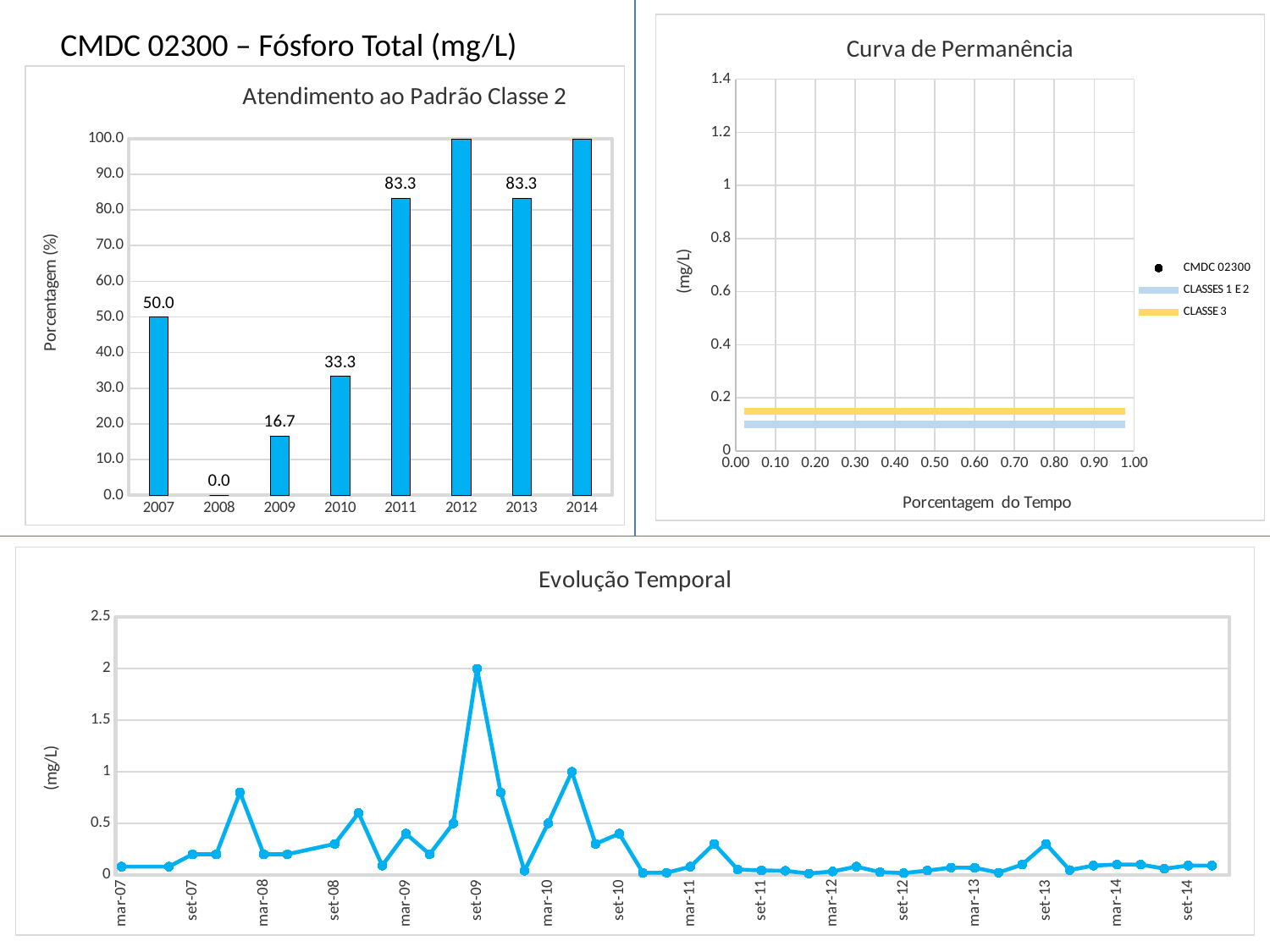
In the 'Atendimento ao Padrão Classe 2' chart, which year has the lowest value? 2008 In the 'Atendimento ao Padrão Classe 2' chart, which year has the larger value, 2009 or 2010? 2010 How many years are shown in the 'Atendimento ao Padrão Classe 2' chart? 8 In the 'Atendimento ao Padrão Classe 2' chart, what is the value for 2007? 50.0 How many series does the legend of the 'Curva de Permanência' chart list? 3 In the 'Evolução Temporal' chart, is the highest value greater or less than 1.5? greater In the 'Atendimento ao Padrão Classe 2' chart, what is the difference between the values for 2011 and 2010? 50.0 In the 'Atendimento ao Padrão Classe 2' chart, what is the value for 2011? 83.3 What are the legend entries in the 'Curva de Permanência' chart? CMDC 02300, CLASSES 1 E 2, CLASSE 3 What kind of chart is 'Evolução Temporal'? line chart In the 'Atendimento ao Padrão Classe 2' chart, is the value for 2012 greater or less than 90.0? greater What kind of chart is 'Atendimento ao Padrão Classe 2'? bar chart